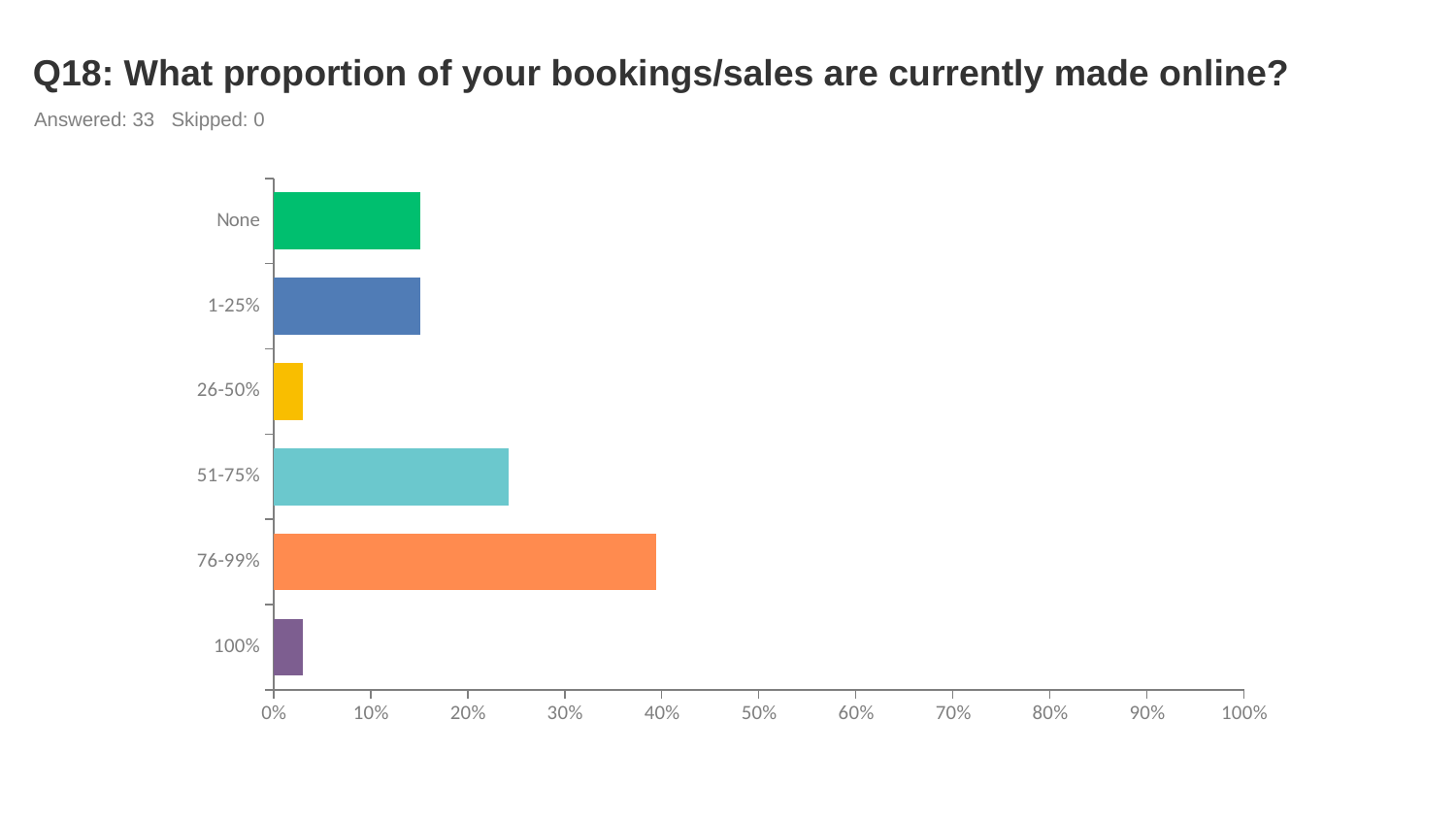
How many respondents answered the question shown in the chart title? 33 Is the value for 76-99% greater or less than 30%? greater Is the value for 1-25% greater or less than 20%? less Which has a larger value, 51-75% or None? 51-75% Is the value for 100% greater or less than 10%? less Which has a larger value, 76-99% or 51-75%? 76-99% What kind of chart is shown on the slide? bar chart How many categories are plotted in the chart? 6 Which category has the highest value? 76-99%